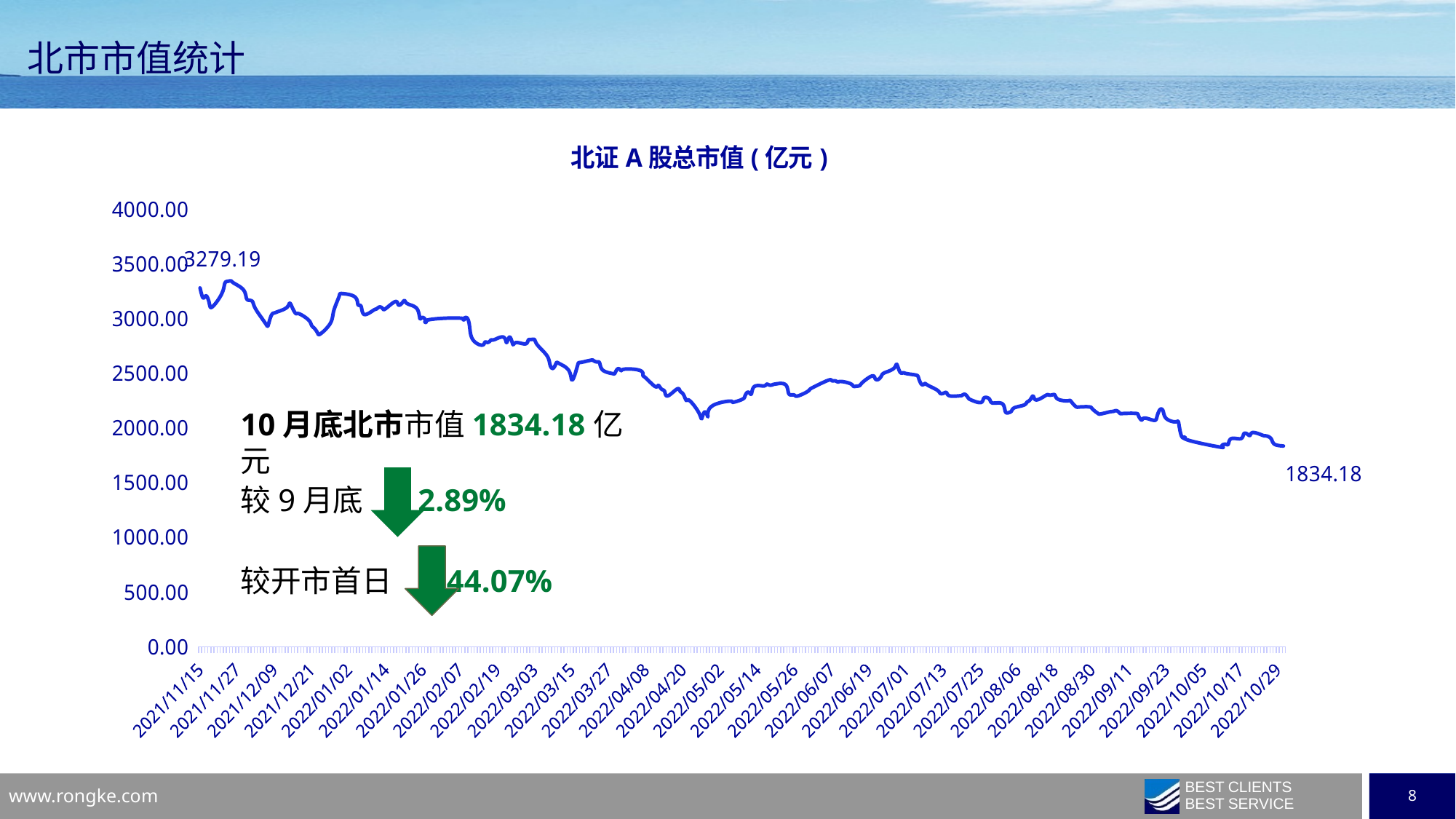
What is the value labelled at the start of the line (2021/11/15)? 3279.19 What is the value labelled at the end of the line (2022/10/29)? 1834.18 What is the difference between the first labelled value (3279.19) and the last labelled value (1834.18)? 1445.01 Is the value around 2022/01/02 greater or less than 2500? greater What is the title of the chart? 北证A股总市值(亿元) Is the value around 2022/04/20 greater or less than 3000? less What type of chart is shown on the slide? line chart Is the value around 2022/07/01 greater or less than 2000? greater Which is larger, the value at 2021/11/15 or the value at 2022/10/29? 2021/11/15 What is the maximum value shown on the y axis? 4000.00 Does the line generally rise or fall from left to right along the x axis? fall